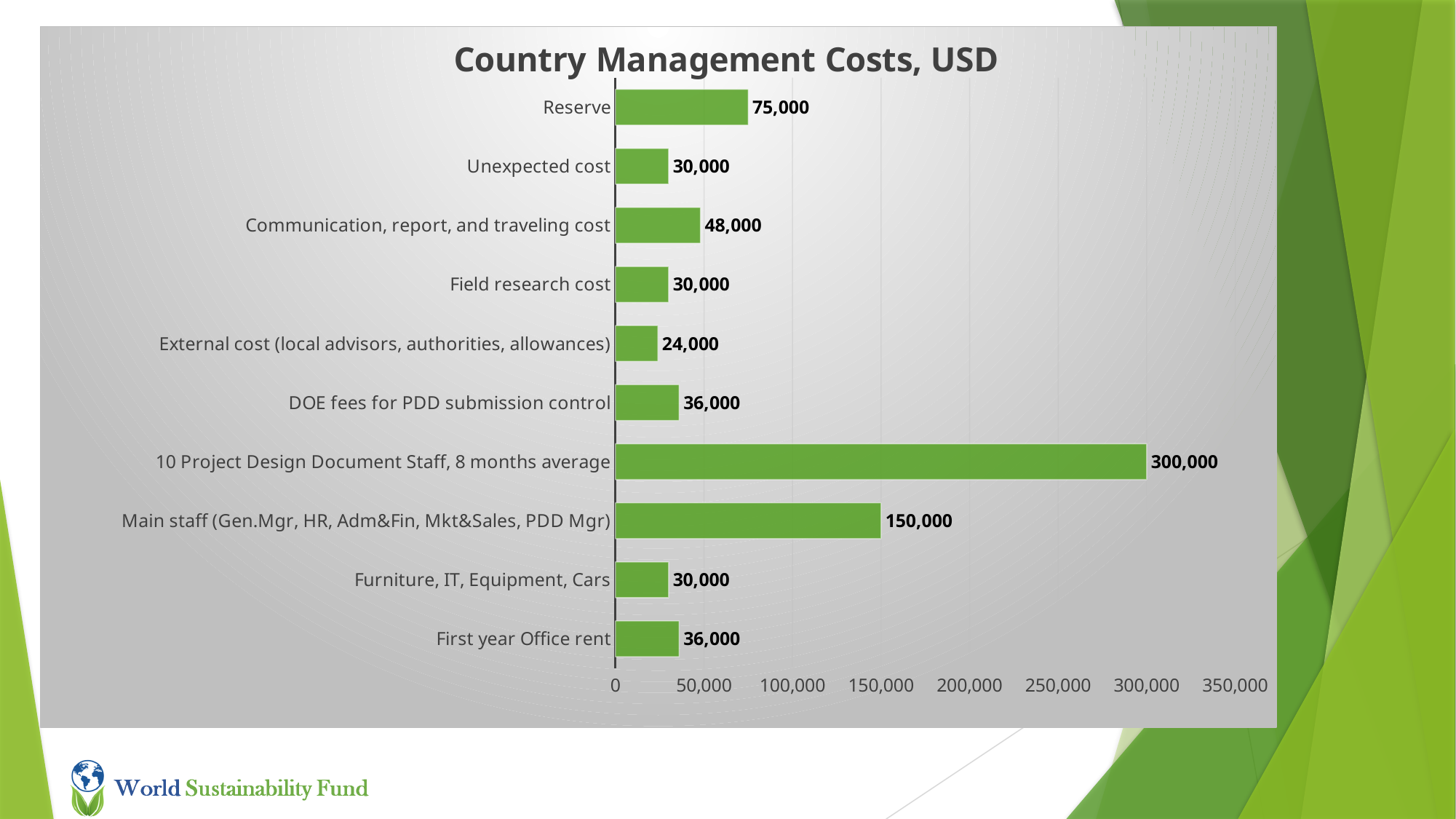
What is the value for Reserve? 75,000 How many categories are shown in the chart? 10 Is the value for DOE fees for PDD submission control greater or less than 50,000? less What is the value for External cost (local advisors, authorities, allowances)? 24,000 What is the title of the chart? Country Management Costs, USD Which is larger, the value for Reserve or the value for Communication, report, and traveling cost? Reserve What kind of chart is shown on the slide? bar chart What is the value for Main staff (Gen.Mgr, HR, Adm&Fin, Mkt&Sales, PDD Mgr)? 150,000 Which category has the highest value? 10 Project Design Document Staff, 8 months average Which category has the lowest value? External cost (local advisors, authorities, allowances) What is the difference between the value for 10 Project Design Document Staff, 8 months average and the value for Main staff (Gen.Mgr, HR, Adm&Fin, Mkt&Sales, PDD Mgr)? 150,000 What is the value for Communication, report, and traveling cost? 48,000